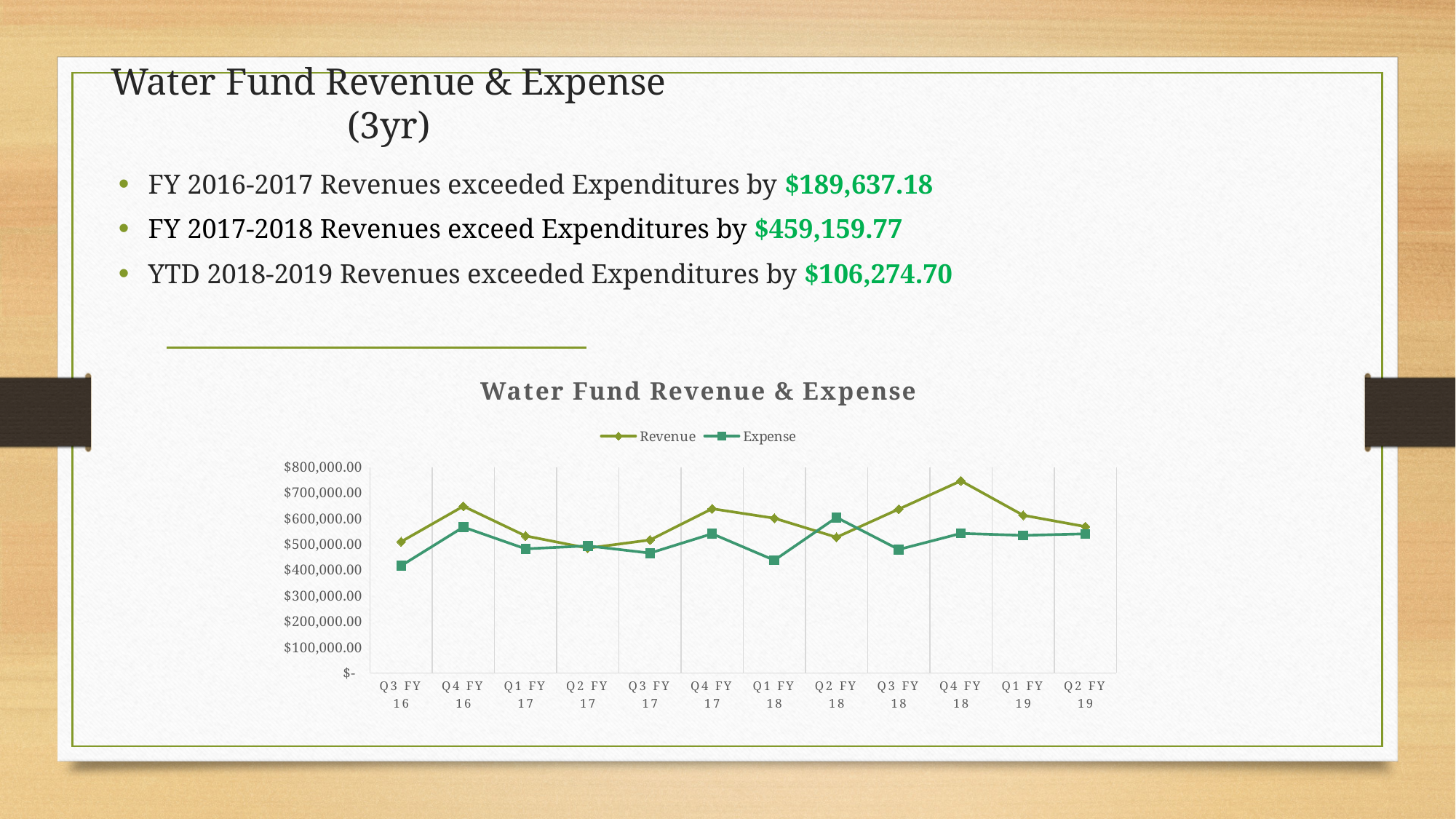
Is the Revenue value for Q4 FY 18 greater or less than $700,000.00? greater What is the title of the chart? Water Fund Revenue & Expense In Q2 FY 18, which is larger, Revenue or Expense? Expense What kind of chart is shown on the slide? Line chart How many series does the chart legend list? 2 In which quarter does the Revenue series reach its highest value? Q4 FY 18 Is the Expense value for Q3 FY 16 greater or less than $500,000.00? less Does the Revenue series rise or fall from Q2 FY 18 to Q4 FY 18? Rise How many quarters are plotted along the x axis of the chart? 12 In which quarter does the Expense series reach its highest value? Q2 FY 18 Is the Revenue value for Q4 FY 16 greater or less than $600,000.00? greater